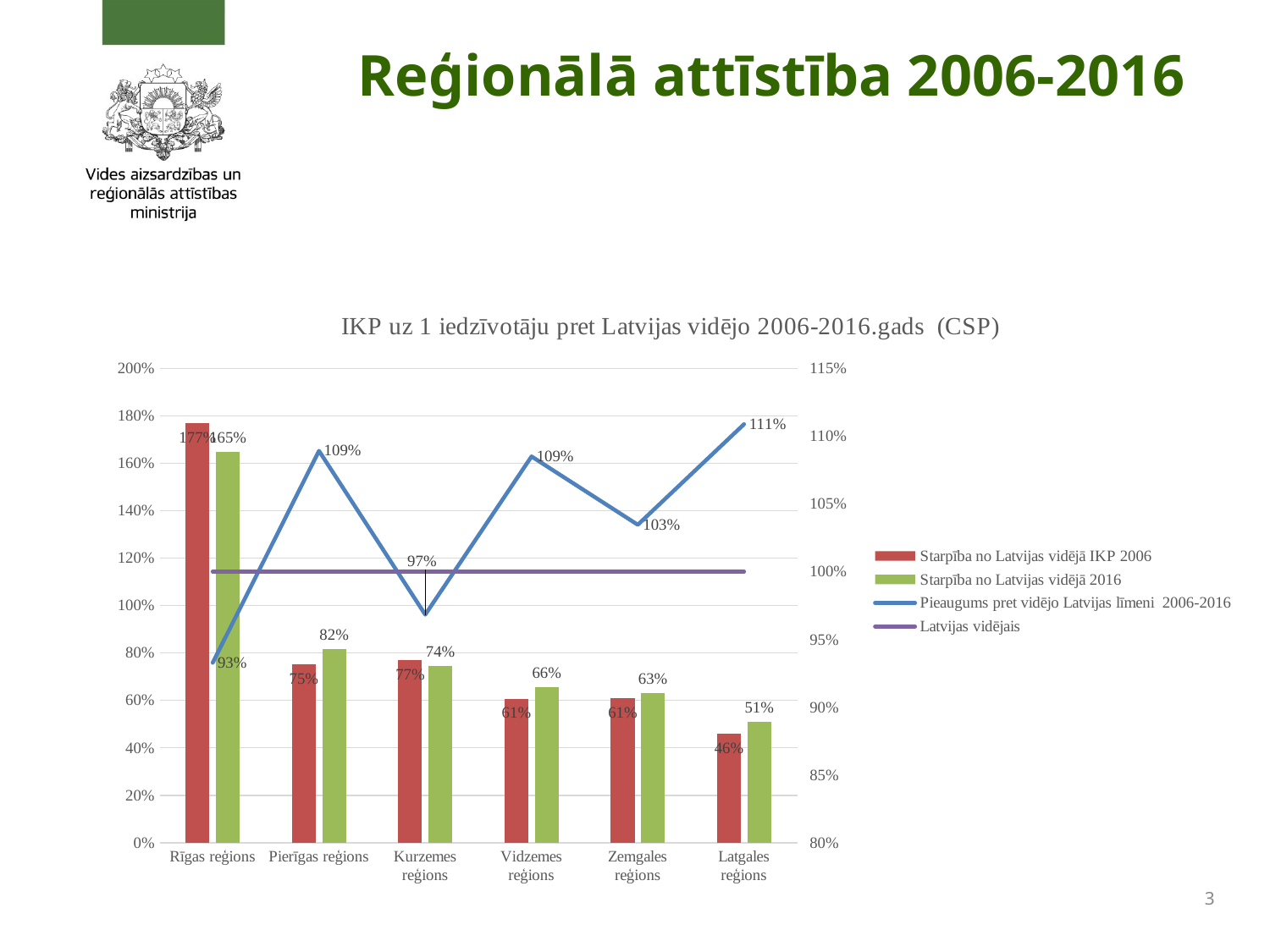
What is the value of Pieaugums pret vidējo Latvijas līmeni 2006-2016 for Kurzemes reģions? 97% What kind of chart is this? A combined bar and line chart How many regions are shown on the x axis? 6 What is the title of the chart? IKP uz 1 iedzīvotāju pret Latvijas vidējo 2006-2016.gads (CSP) Which is larger for Kurzemes reģions: the 2006 value or the 2016 value? The 2006 value (77%) What is the value of Starpība no Latvijas vidējā IKP 2006 for Rīgas reģions? 177% How many series does the legend list? 4 What is the difference between the 2006 and 2016 values for Rīgas reģions? 12% Which region has the lowest value for Starpība no Latvijas vidējā IKP 2006? Latgales reģions What is the value of Pieaugums pret vidējo Latvijas līmeni 2006-2016 for Latgales reģions? 111% Which region has the highest value for Starpība no Latvijas vidējā 2016? Rīgas reģions What is the value of Starpība no Latvijas vidējā 2016 for Pierīgas reģions? 82%